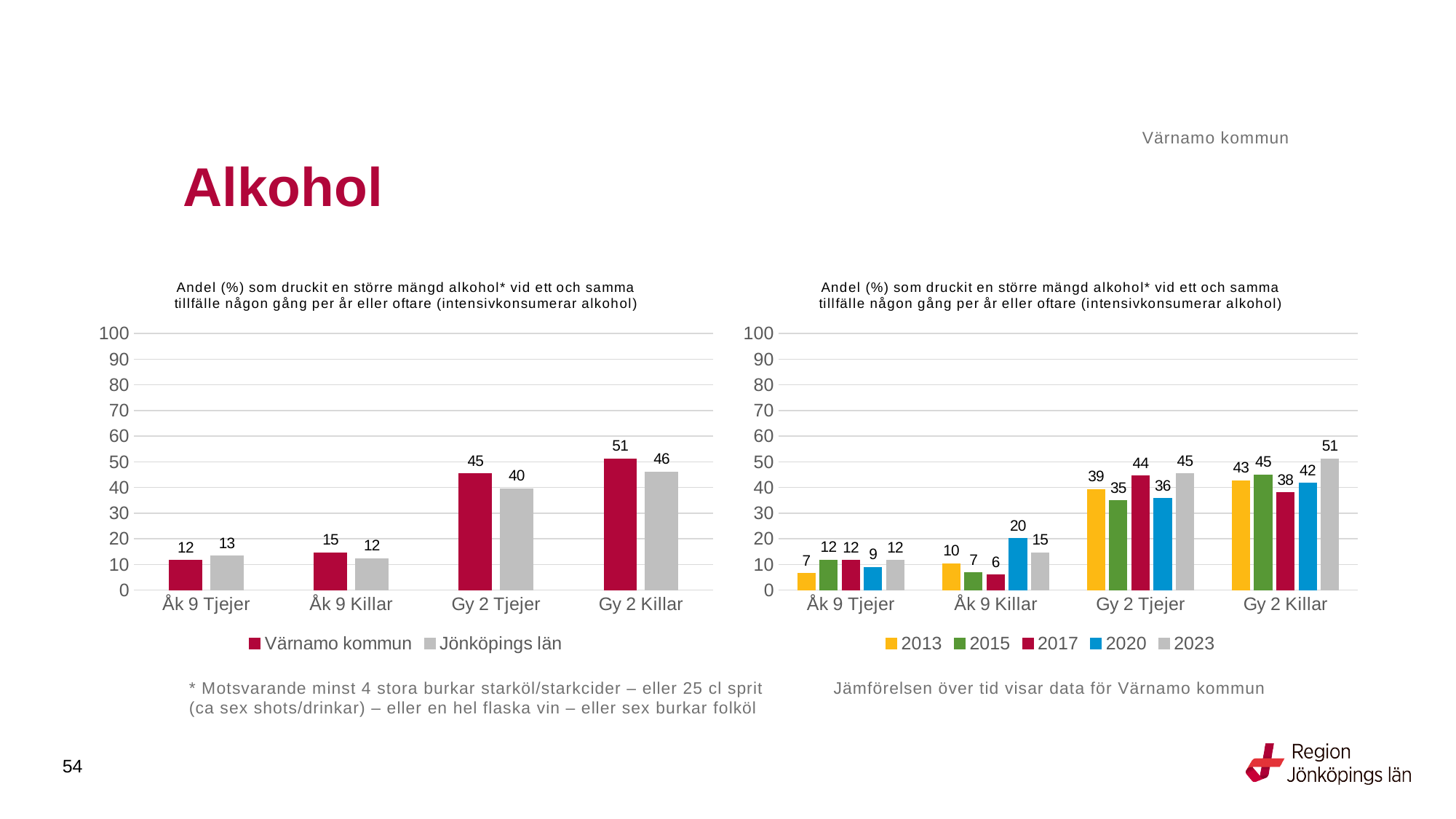
What kind of chart is the right chart? Bar chart In the left chart, which category has the lowest value for Värnamo kommun? Åk 9 Tjejer In the left chart, what is the value for Värnamo kommun for Gy 2 Killar? 51 In the left chart, what is the value for Jönköpings län for Gy 2 Tjejer? 40 In the right chart, which year has the highest value for Gy 2 Killar? 2023 In the left chart, what is the difference between Värnamo kommun and Jönköpings län for Gy 2 Killar? 5 How many series does the legend of the right chart list? 5 In the right chart, what is the difference between 2023 and 2013 for Gy 2 Killar? 8 In the right chart, what is the value for 2020 for Åk 9 Killar? 20 In the right chart, what is the value for 2013 for Gy 2 Tjejer? 39 How many series does the legend of the left chart list? 2 In the left chart, which is larger for Åk 9 Killar: Värnamo kommun or Jönköpings län? Värnamo kommun